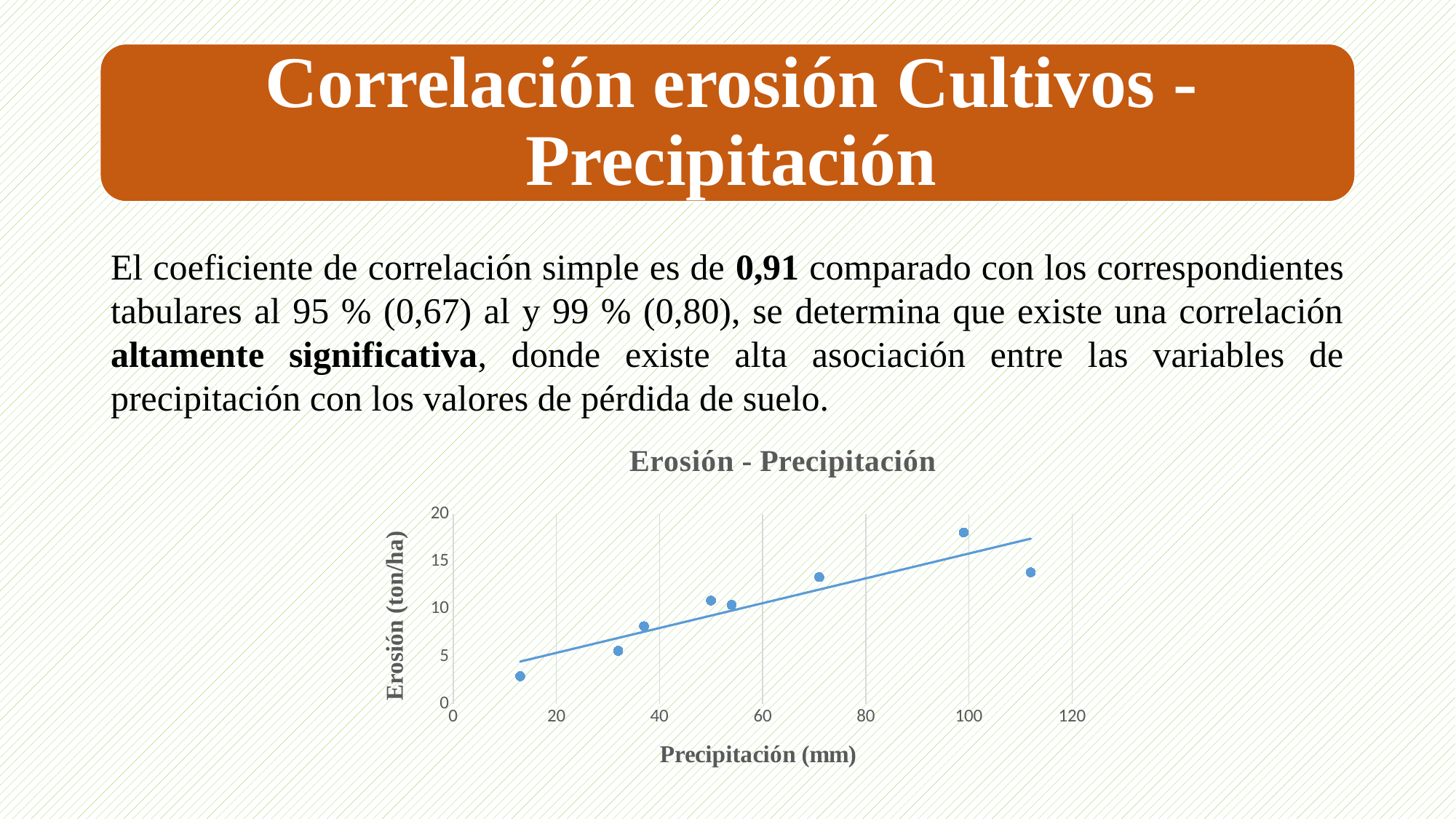
Is the erosion value of the lowest point in the chart greater or less than 5? less Do the erosion values generally rise or fall as precipitation increases along the x axis? rise What kind of chart is shown on the slide? scatter chart What is the label of the vertical axis of the chart? Erosión (ton/ha) Is the erosion value of the point near 71 mm of precipitation greater or less than 10? greater How many data points are plotted in the Erosión - Precipitación chart? 8 Which point has the higher erosion value: the one near 99 mm of precipitation or the one near 112 mm? the one near 99 mm How many points in the chart have an erosion value above 15 ton/ha? 1 What is the title of the chart? Erosión - Precipitación Is the erosion value of the point with the highest precipitation (near 112 mm) greater or less than 15? less